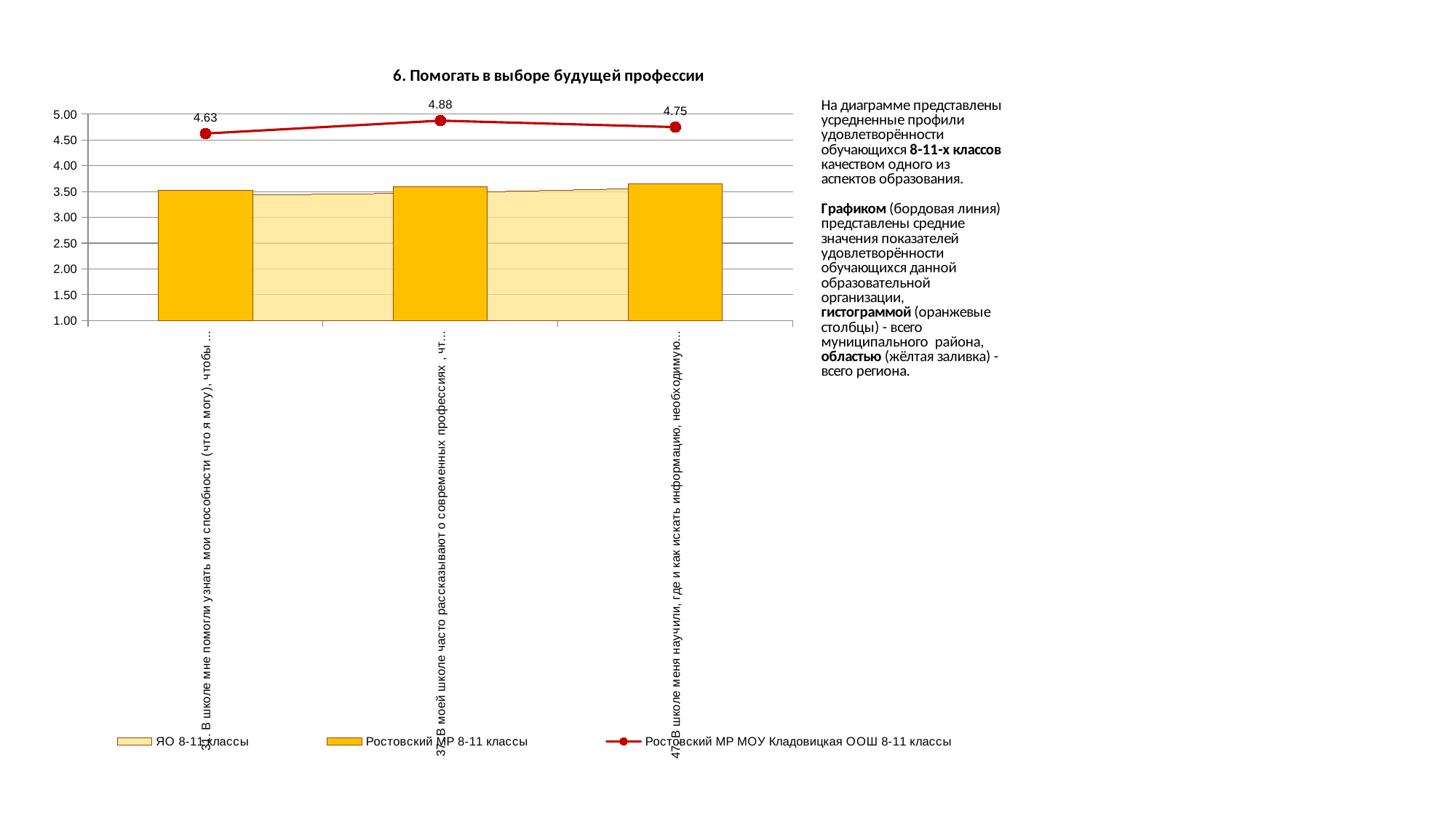
What is the value of the Ростовский МР МОУ Кладовицкая ООШ 8-11 классы line for the category "В школе мне помогли узнать мои способности"? 4.63 Is the Ростовский МР 8-11 классы bar for "В школе меня научили, где и как искать информацию" greater or less than 4.00? less For which category is the Ростовский МР МОУ Кладовицкая ООШ 8-11 классы line highest? В моей школе часто рассказывают о современных профессиях What is the value of the Ростовский МР МОУ Кладовицкая ООШ 8-11 классы line for the category "В моей школе часто рассказывают о современных профессиях"? 4.88 Which category has the larger school line value: "В школе мне помогли узнать мои способности" or "В школе меня научили, где и как искать информацию"? В школе меня научили, где и как искать информацию For which category is the Ростовский МР МОУ Кладовицкая ООШ 8-11 классы line lowest? В школе мне помогли узнать мои способности What is the difference between the highest and lowest values of the Ростовский МР МОУ Кладовицкая ООШ 8-11 классы line? 0.25 How many categories are shown on the x axis of the chart? 3 What is the value of the Ростовский МР МОУ Кладовицкая ООШ 8-11 классы line for the category "В школе меня научили, где и как искать информацию"? 4.75 What is the title of the chart? 6. Помогать в выборе будущей профессии How much higher is the school line value for "В моей школе часто рассказывают о современных профессиях" than for "В школе меня научили, где и как искать информацию"? 0.13 How many series does the chart legend list? 3